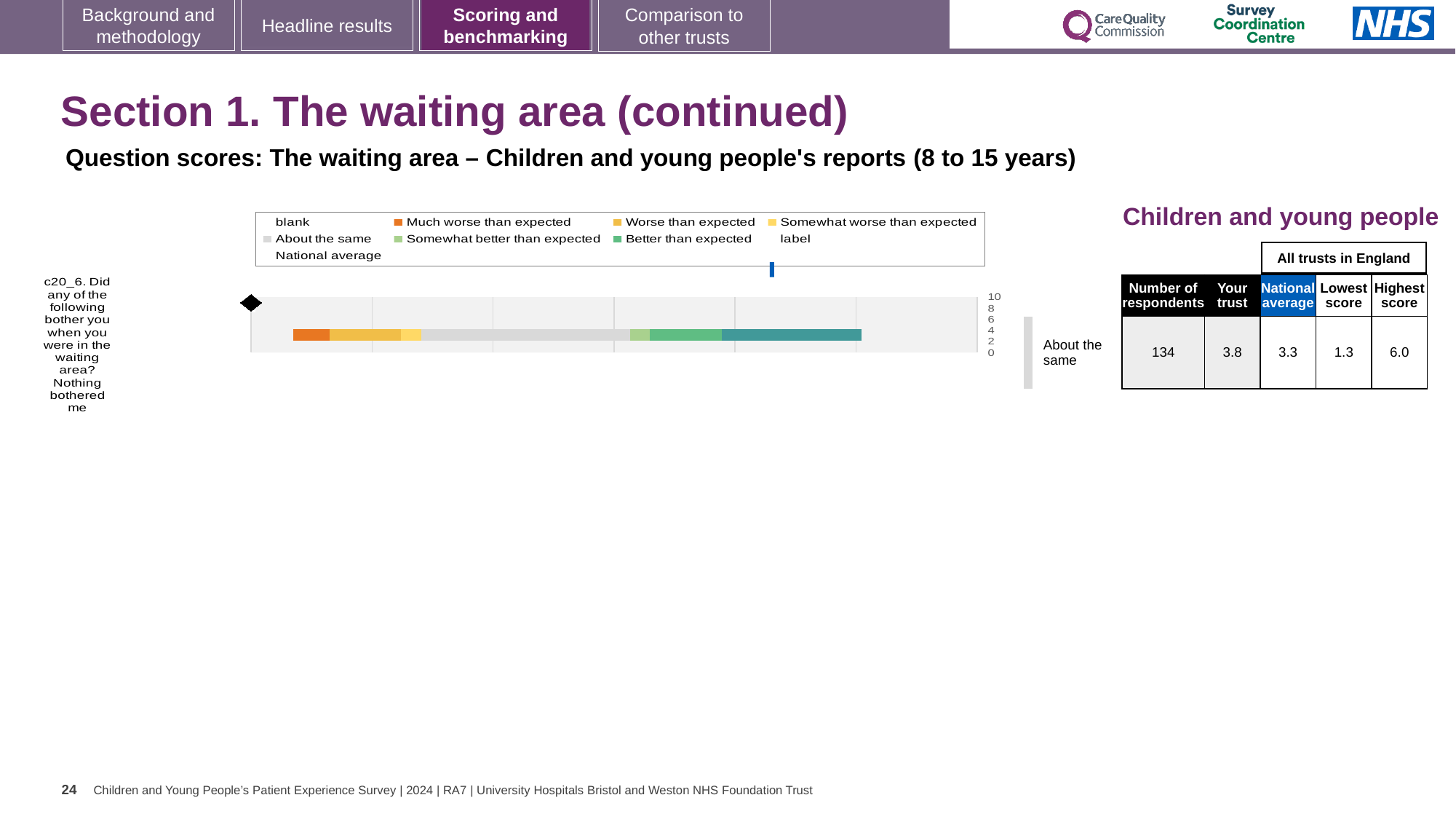
How many survey questions are plotted in the chart? 1 What is the lowest score among all trusts in England for question c20_6? 1.3 Which legend entry is shown in orange in the chart? Much worse than expected What is the highest score among all trusts in England for question c20_6? 6.0 What is the national average score for question c20_6? 3.3 Which is larger for question c20_6, the 'Your trust' score or the national average? Your trust What is the difference between the highest and lowest scores across all trusts in England for question c20_6? 4.7 What is the 'Your trust' score for question c20_6? 3.8 What is the difference between the 'Your trust' score and the national average for question c20_6? 0.5 How many respondents answered question c20_6? 134 What kind of chart is used to show the benchmarking result for question c20_6? bar chart Which benchmarking category is the trust's result for c20_6 labelled as? About the same